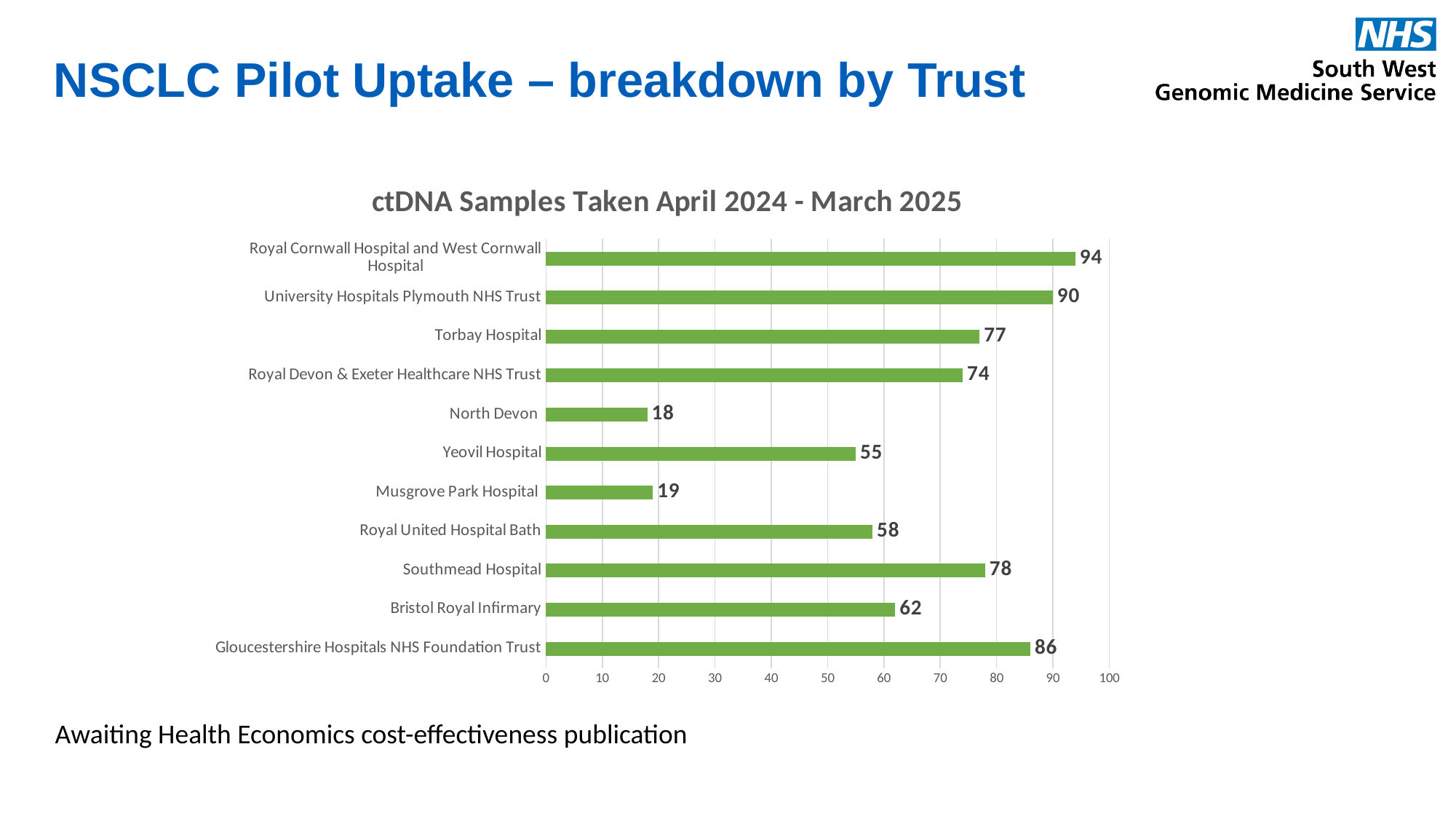
What is the title of the chart? ctDNA Samples Taken April 2024 - March 2025 Is the value for Royal Devon & Exeter Healthcare NHS Trust greater or less than 70? greater What is the difference between the values for University Hospitals Plymouth NHS Trust and Bristol Royal Infirmary? 28 What is the value for Yeovil Hospital? 55 Which trust has the highest number of ctDNA samples taken? Royal Cornwall Hospital and West Cornwall Hospital Which trust has the lowest number of ctDNA samples taken? North Devon How many ctDNA samples were taken at Torbay Hospital? 77 What colour are the bars in the chart? Green Which has a higher value, Southmead Hospital or Royal United Hospital Bath? Southmead Hospital What is the value for Gloucestershire Hospitals NHS Foundation Trust? 86 What kind of chart is shown on the slide? Bar chart How many trusts are shown in the chart? 11